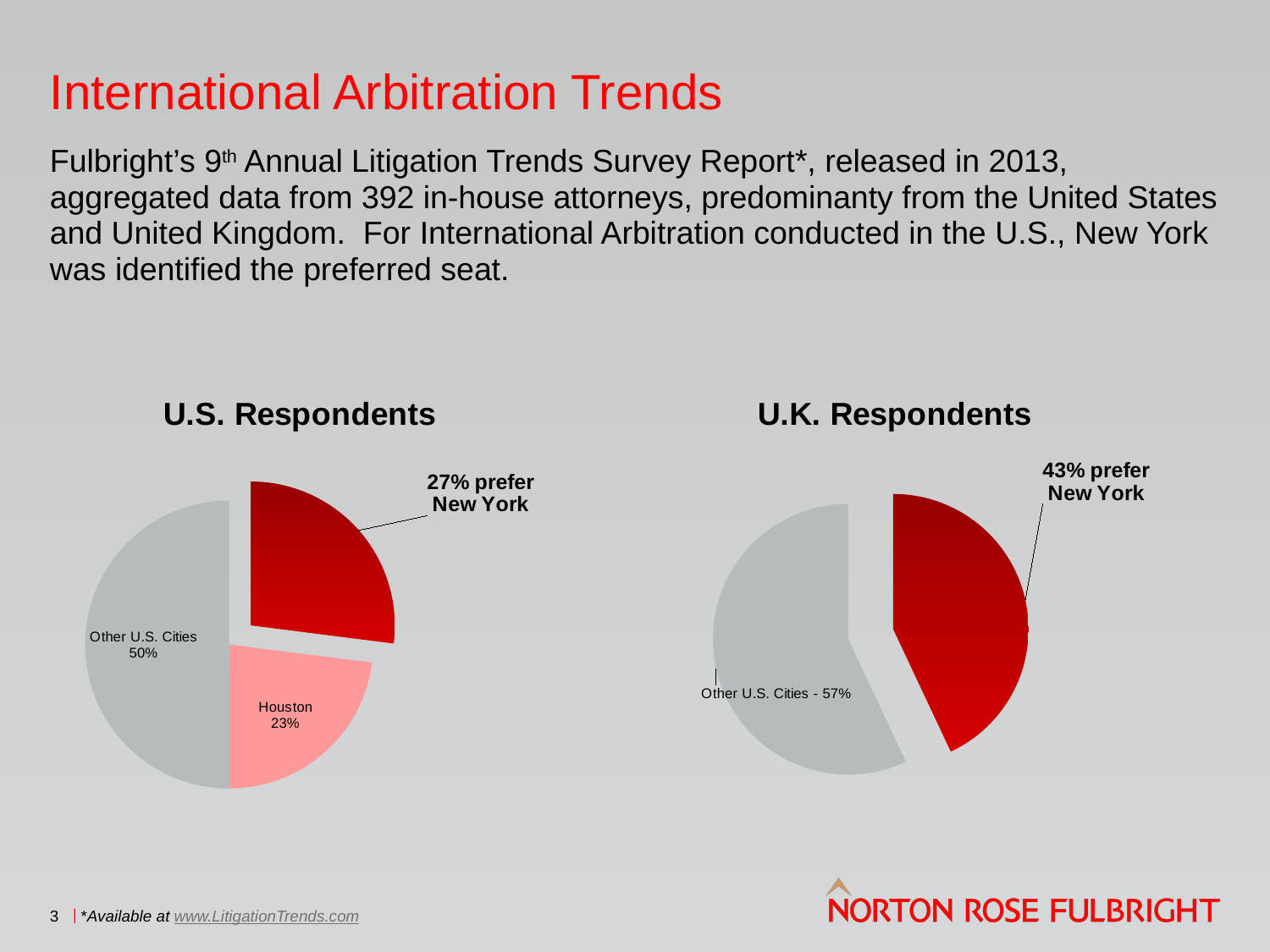
In the U.K. Respondents chart, what percentage of respondents prefer New York? 43% In the U.S. Respondents chart, what is the value for Other U.S. Cities? 50% In the U.S. Respondents chart, what is the difference between the Other U.S. Cities share and the New York share? 23% In the U.K. Respondents chart, what is the value for Other U.S. Cities? 57% How many slices does the U.K. Respondents pie chart have? 2 Which chart shows a larger share preferring New York, U.S. Respondents or U.K. Respondents? U.K. Respondents How many slices does the U.S. Respondents pie chart have? 3 In the U.S. Respondents chart, which slice is the largest? Other U.S. Cities What type of chart is used for the U.K. Respondents data? Pie chart In the U.S. Respondents chart, what is the value for Houston? 23% In the U.S. Respondents chart, what percentage of respondents prefer New York? 27% In the U.S. Respondents chart, which slice is the smallest? Houston